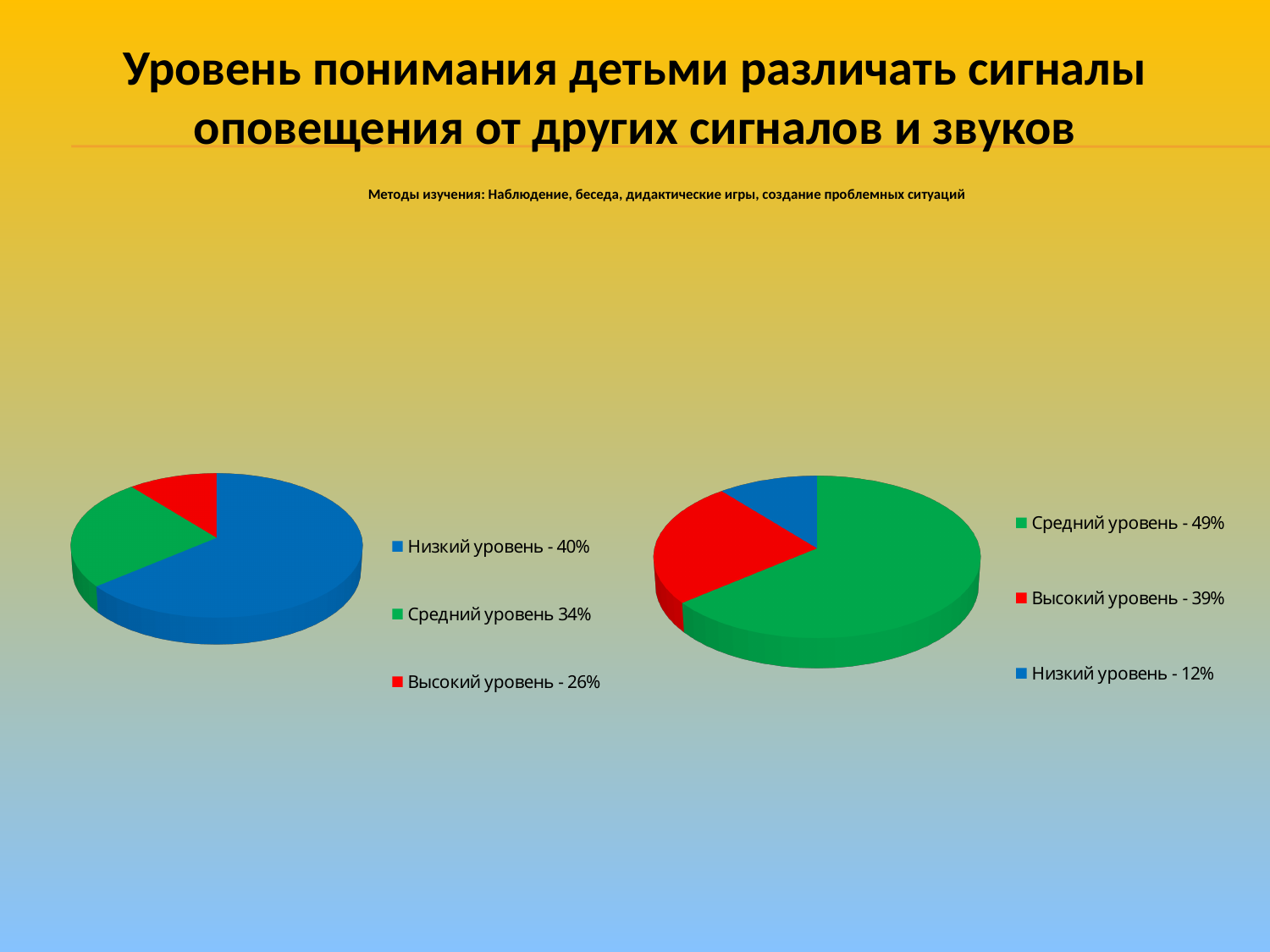
In the right pie chart, what is the difference between Средний уровень and Высокий уровень? 10% In the left pie chart, which level has the largest slice? Низкий уровень In the right pie chart, what share is shown for Низкий уровень? 12% In the right pie chart, which level has the largest slice? Средний уровень In the right pie chart, which is larger: Высокий уровень or Низкий уровень? Высокий уровень What kind of chart is the left chart on the slide? pie chart In the left pie chart, what share is shown for Низкий уровень? 40% In the left pie chart, what share is shown for Высокий уровень? 26% How many slices does the right pie chart have? 3 In the left pie chart, what is the difference between Низкий уровень and Средний уровень? 6% In the left pie chart, which level has the smallest slice? Высокий уровень In the right pie chart, what share is shown for Средний уровень? 49%